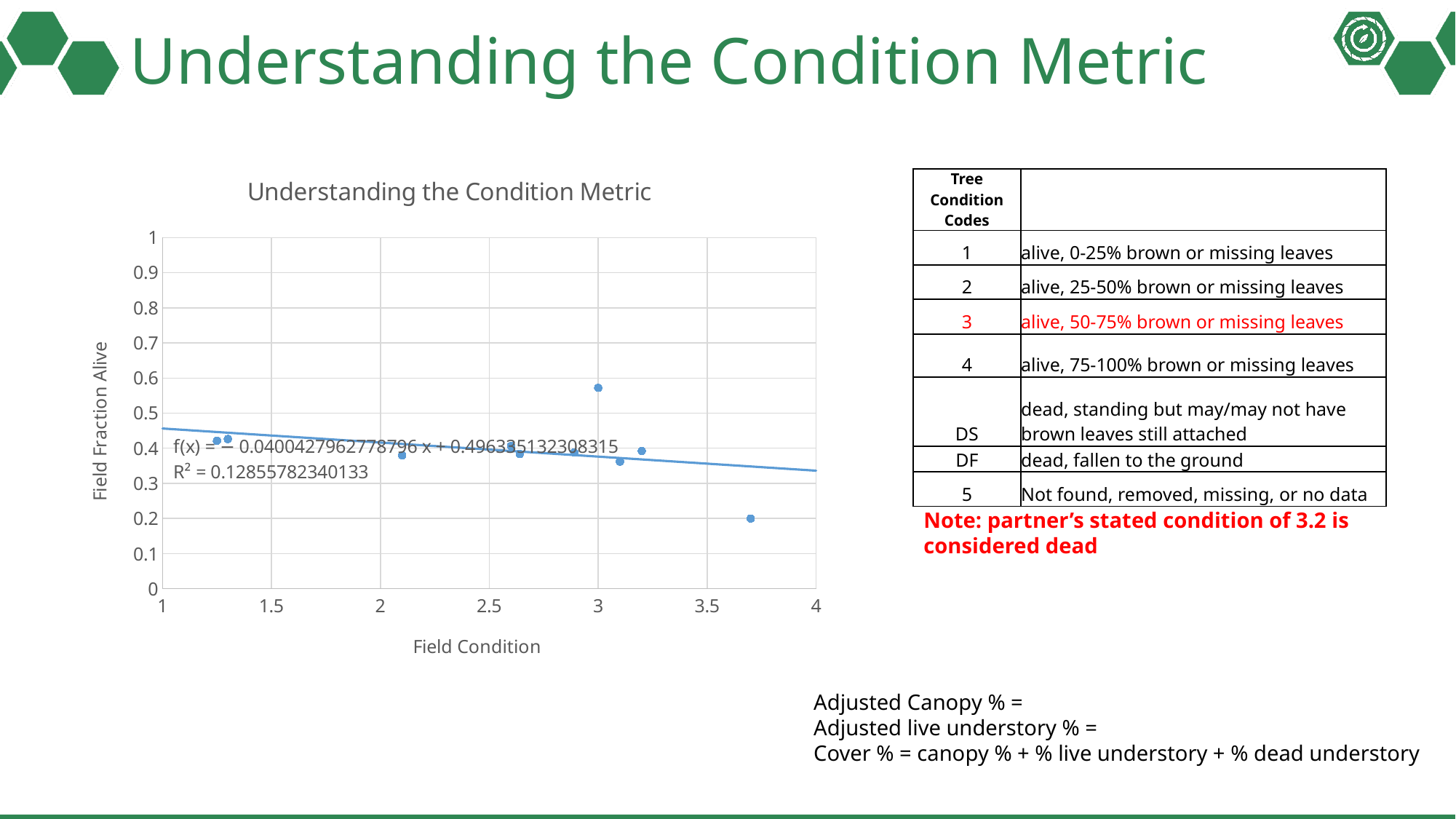
What is the maximum value shown on the chart's x axis? 4 Which point has a higher Field Fraction Alive: the one at Field Condition 3 or the one at Field Condition 3.7? Field Condition 3 What is the label of the chart's vertical axis? Field Fraction Alive Does the trendline on the chart rise or fall as Field Condition increases? Fall What is the slope of the fitted line shown in the chart's equation? −0.0400427962778796 What is the title of the chart? Understanding the Condition Metric At which Field Condition value is the highest Field Fraction Alive point plotted? 3 What kind of chart is shown on the slide? Scatter chart What R² value is printed on the chart? 0.12855782340133 Is the Field Fraction Alive for the point at Field Condition 3.7 greater or less than 0.3? less Is the Field Fraction Alive for the highest point, at Field Condition 3, greater or less than 0.5? greater